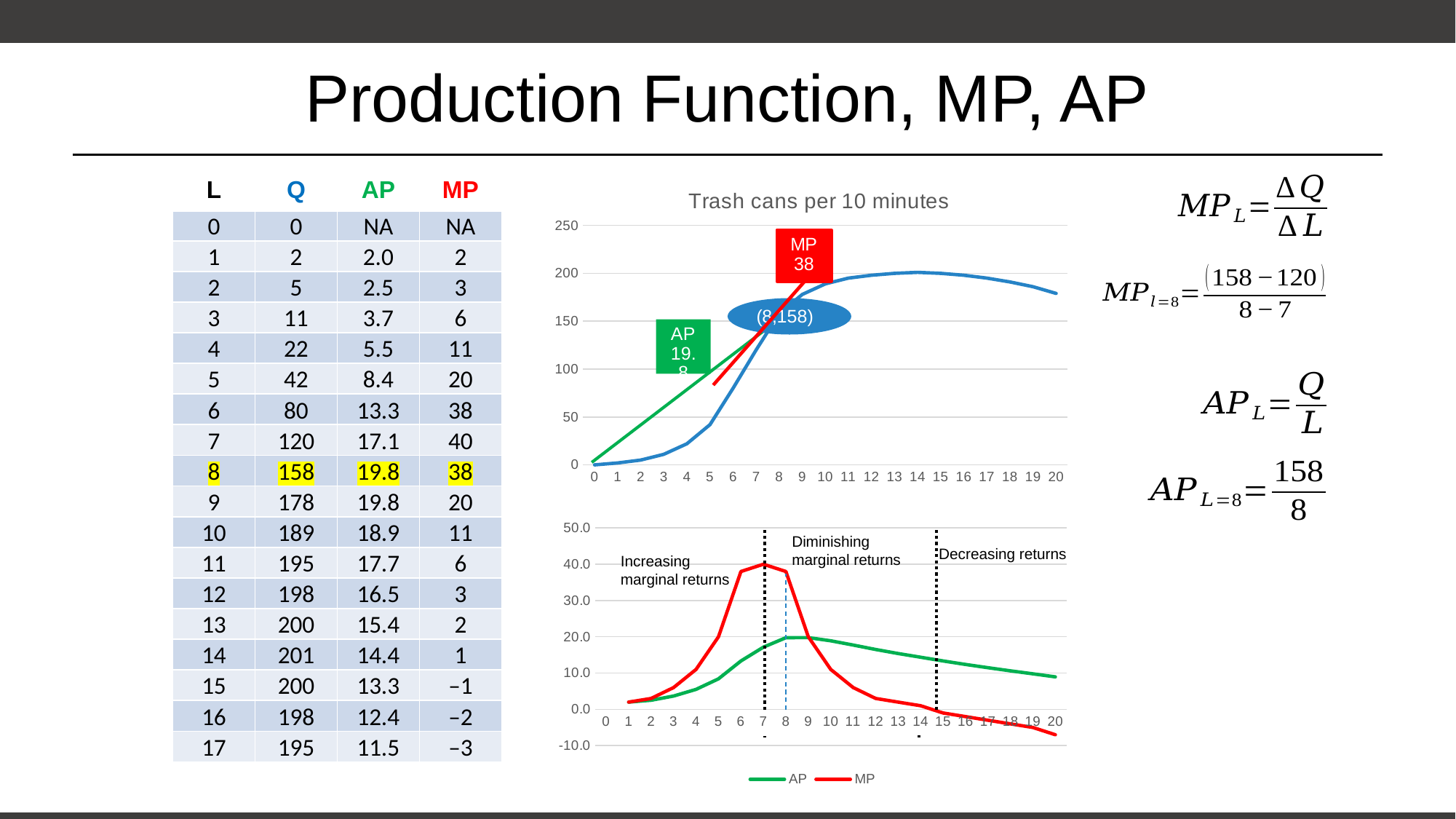
What kind of chart is the top chart titled 'Trash cans per 10 minutes'? line chart What kind of chart is the bottom chart with the AP and MP legend? line chart In the bottom chart, at which value of L does the MP line reach its highest point? 7 In the top chart 'Trash cans per 10 minutes', is the value of the blue curve at L = 3 greater or less than 50? less In the top chart 'Trash cans per 10 minutes', does the blue curve rise or fall between L = 0 and L = 14? rise In the top chart 'Trash cans per 10 minutes', what point is labelled on the blue curve? (8,158) What is the title of the top chart? Trash cans per 10 minutes In the bottom chart, at L = 10, which line is higher, AP or MP? AP How many series does the legend of the bottom chart list? 2 In the top chart 'Trash cans per 10 minutes', is the value of the blue curve at L = 14 greater or less than 150? greater In the bottom chart, is the MP value at L = 7 greater or less than 30.0? greater In the top chart 'Trash cans per 10 minutes', what MP value is shown in the red label? 38